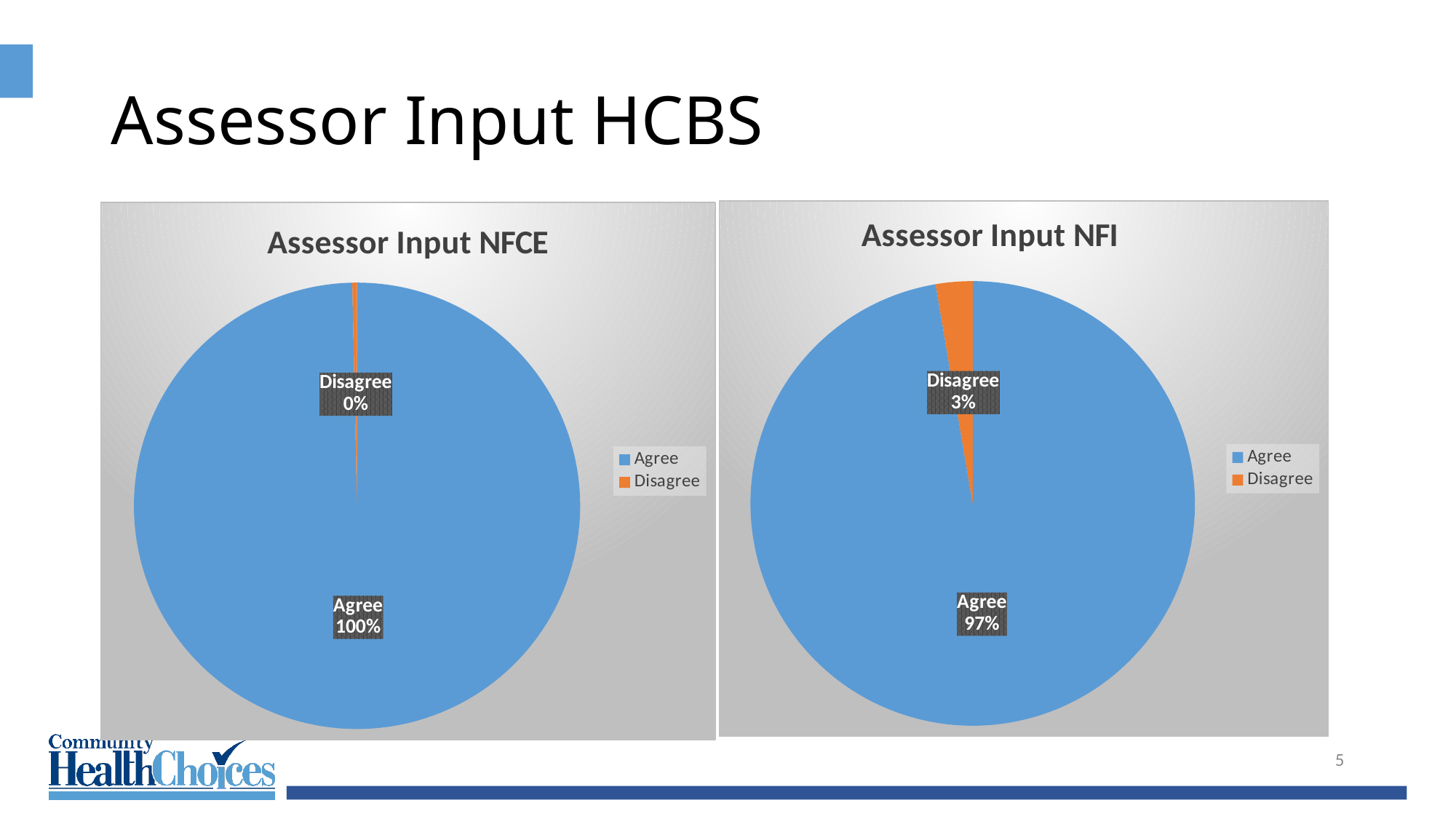
In the 'Assessor Input NFCE' chart, what percentage is shown for Agree? 100% What type of chart is 'Assessor Input NFCE'? Pie chart How many entries does the legend of the 'Assessor Input NFCE' chart list? 2 In the 'Assessor Input NFI' chart, what colour is the Disagree slice? Orange In the 'Assessor Input NFI' chart, what percentage is shown for Disagree? 3% In the 'Assessor Input NFCE' chart, what percentage is shown for Disagree? 0% In the 'Assessor Input NFI' chart, what is the difference between the Agree and Disagree percentages? 94% Which chart has the larger Disagree share, 'Assessor Input NFCE' or 'Assessor Input NFI'? Assessor Input NFI In the 'Assessor Input NFI' chart, which slice is the smallest? Disagree In the 'Assessor Input NFI' chart, which slice is the largest? Agree How many slices does the 'Assessor Input NFI' chart have? 2 In the 'Assessor Input NFI' chart, what percentage is shown for Agree? 97%